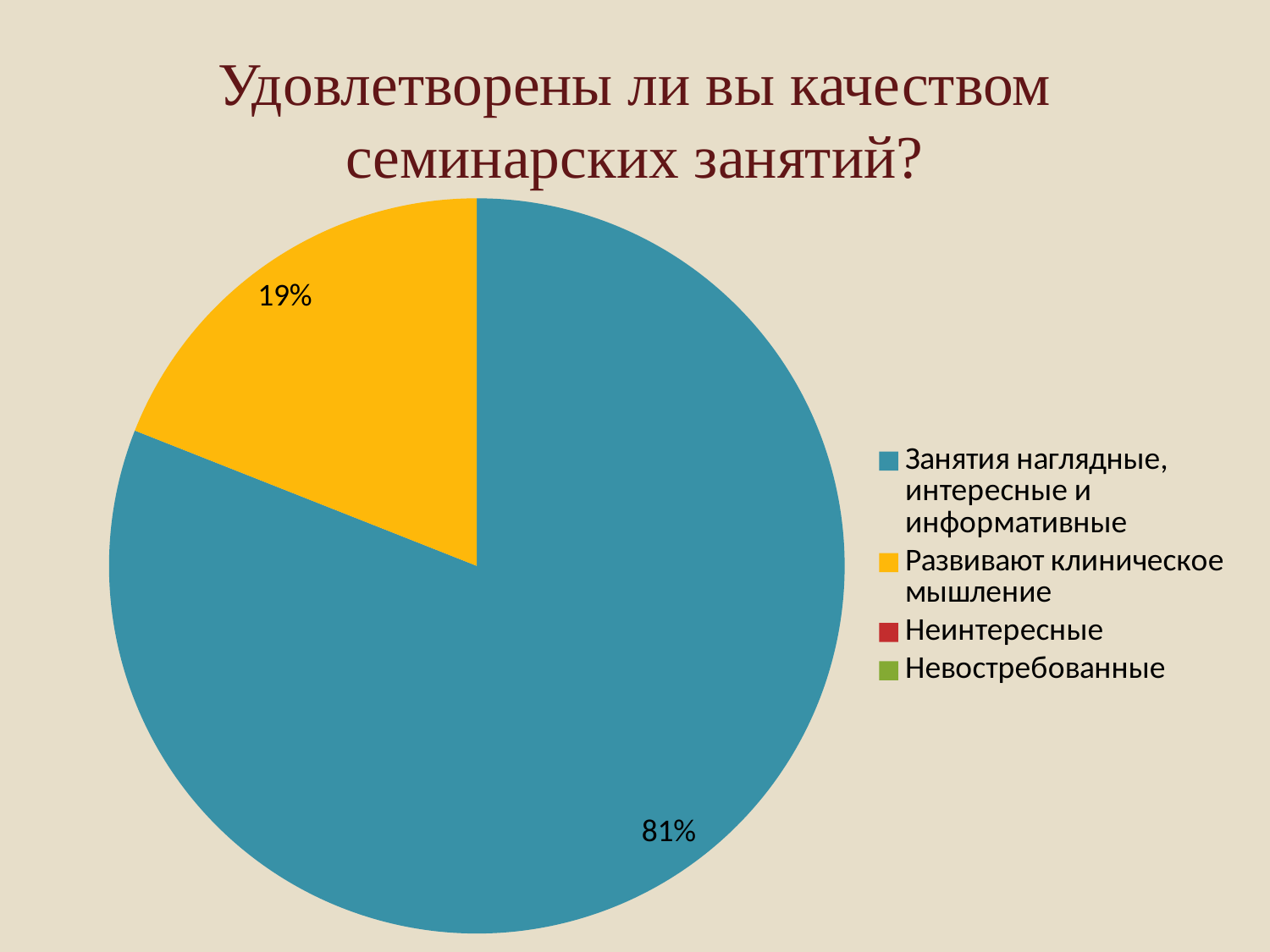
What colour is the slice for "Развивают клиническое мышление"? Yellow What is the title of the chart? Удовлетворены ли вы качеством семинарских занятий? Which is larger: the share for "Развивают клиническое мышление" or the share for "Занятия наглядные, интересные и информативные"? Занятия наглядные, интересные и информативные What is the difference in percentage points between the "Занятия наглядные, интересные и информативные" slice and the "Развивают клиническое мышление" slice? 62 percentage points Which response has the largest slice of the pie? Занятия наглядные, интересные и информативные How many response categories does the legend list? 4 What kind of chart is shown on the slide? Pie chart What share of the pie does the blue slice represent? 81% What percentage of respondents answered "Развивают клиническое мышление"? 19% Is the share for "Развивают клиническое мышление" greater or less than 25%? less What percentage of respondents answered "Занятия наглядные, интересные и информативные"? 81%